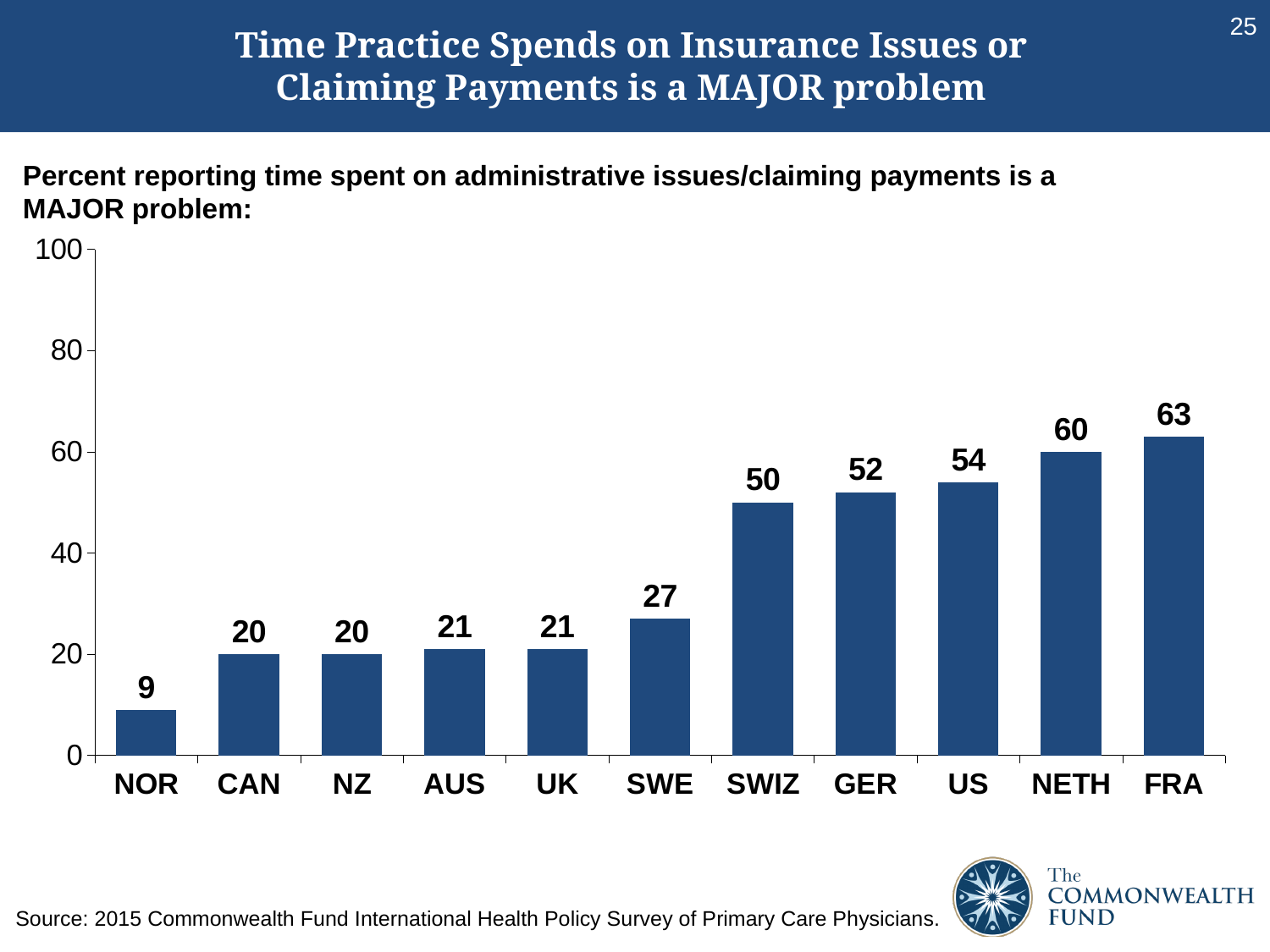
Is the value for US greater or less than 40? greater Which country has the highest value? FRA Do the values rise or fall from left to right across the x axis? rise What kind of chart is shown on the slide? bar chart Which country has the lowest value? NOR What is the value for NOR? 9 How many countries are shown on the chart? 11 What is the value for GER? 52 What is the value for SWE? 27 Which is larger, the value for NETH or the value for SWIZ? NETH What is the difference between the values for FRA and NOR? 54 What is the difference between the values for US and SWE? 27